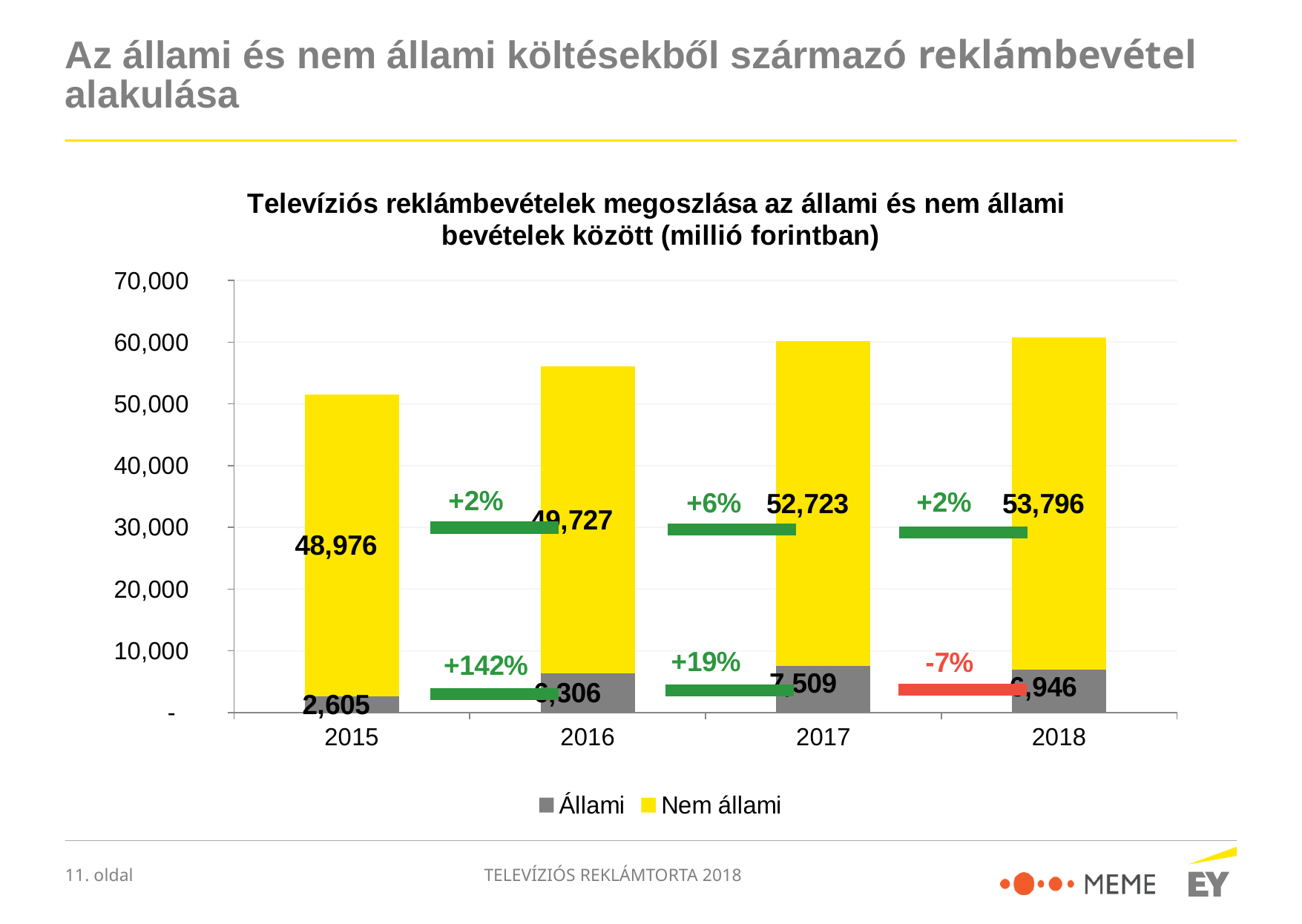
What is the Nem állami value for 2018? 53,796 What is the difference between the Nem állami values for 2018 and 2017? 1,073 How many series does the legend list? 2 What is the Nem állami value for 2017? 52,723 What is the total of the stacked bar for 2015? 51,581 What percentage change is shown for the Állami series between 2017 and 2018? -7% What kind of chart is shown on the slide? Stacked bar chart Is the total height of the 2016 stacked bar greater or less than 60,000? less What is the Állami value for 2015? 2,605 What percentage change is shown for the Állami series between 2015 and 2016? +142% What is the Nem állami value for 2015? 48,976 Which year has the lowest Nem állami value? 2015